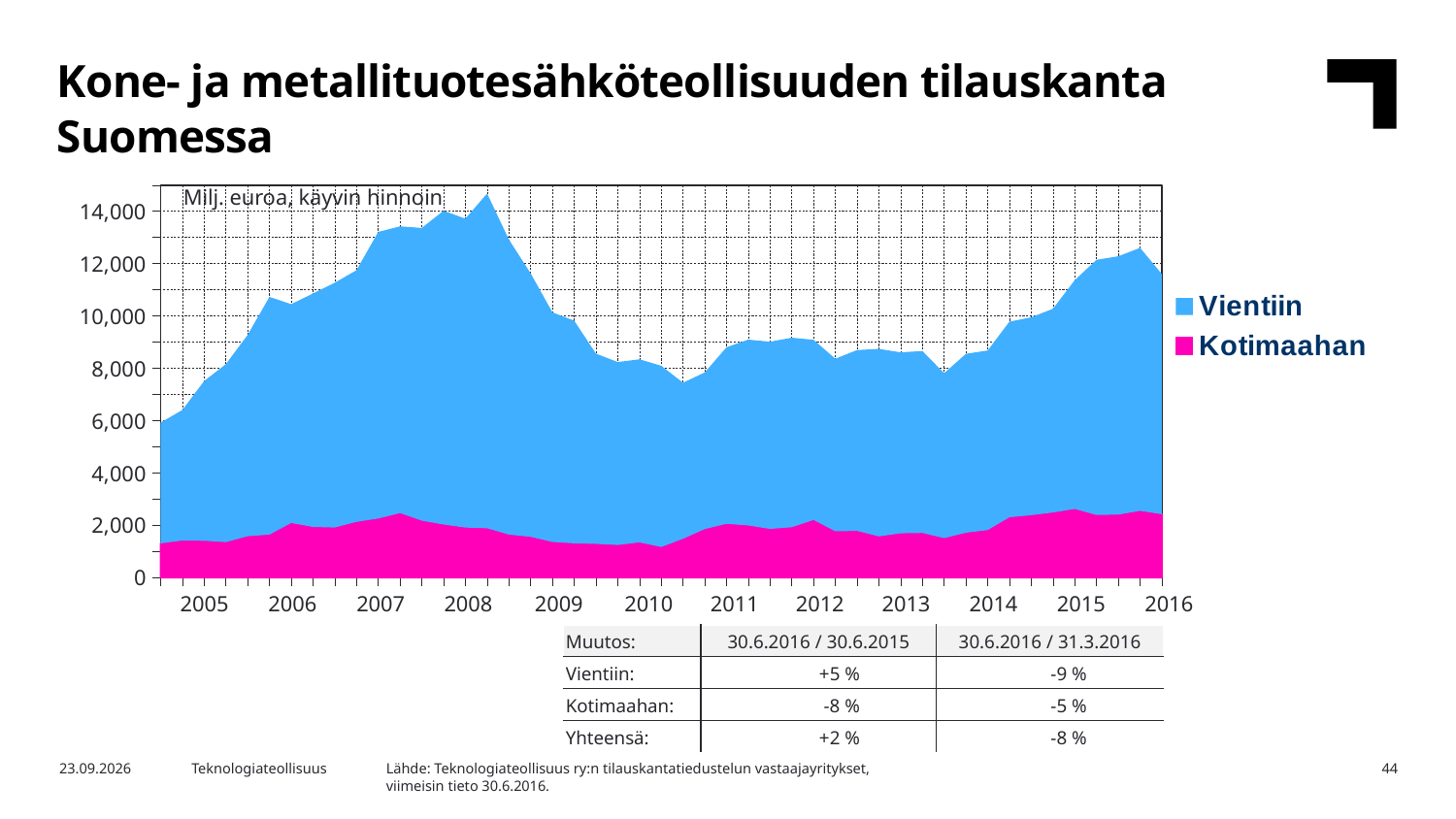
Is the Kotimaahan value at the end of the chart in 2016 greater or less than 2,000? greater How many year labels are shown on the x axis? 12 Which two series are listed in the chart legend? Vientiin and Kotimaahan Is the total order stock at the end of the chart in 2016 greater or less than 10,000? greater How many series does the chart legend list? 2 What kind of chart is shown on the slide? Area chart Which series is larger throughout the chart, Vientiin or Kotimaahan? Vientiin Is the total order stock at the start of 2005 greater or less than 8,000? less Does the total order stock rise or fall between 2013 and 2015? rise What unit label is shown at the top of the chart's plot area? Milj. euroa, käyvin hinnoin Does the total order stock rise or fall between its 2008 peak and 2009? fall